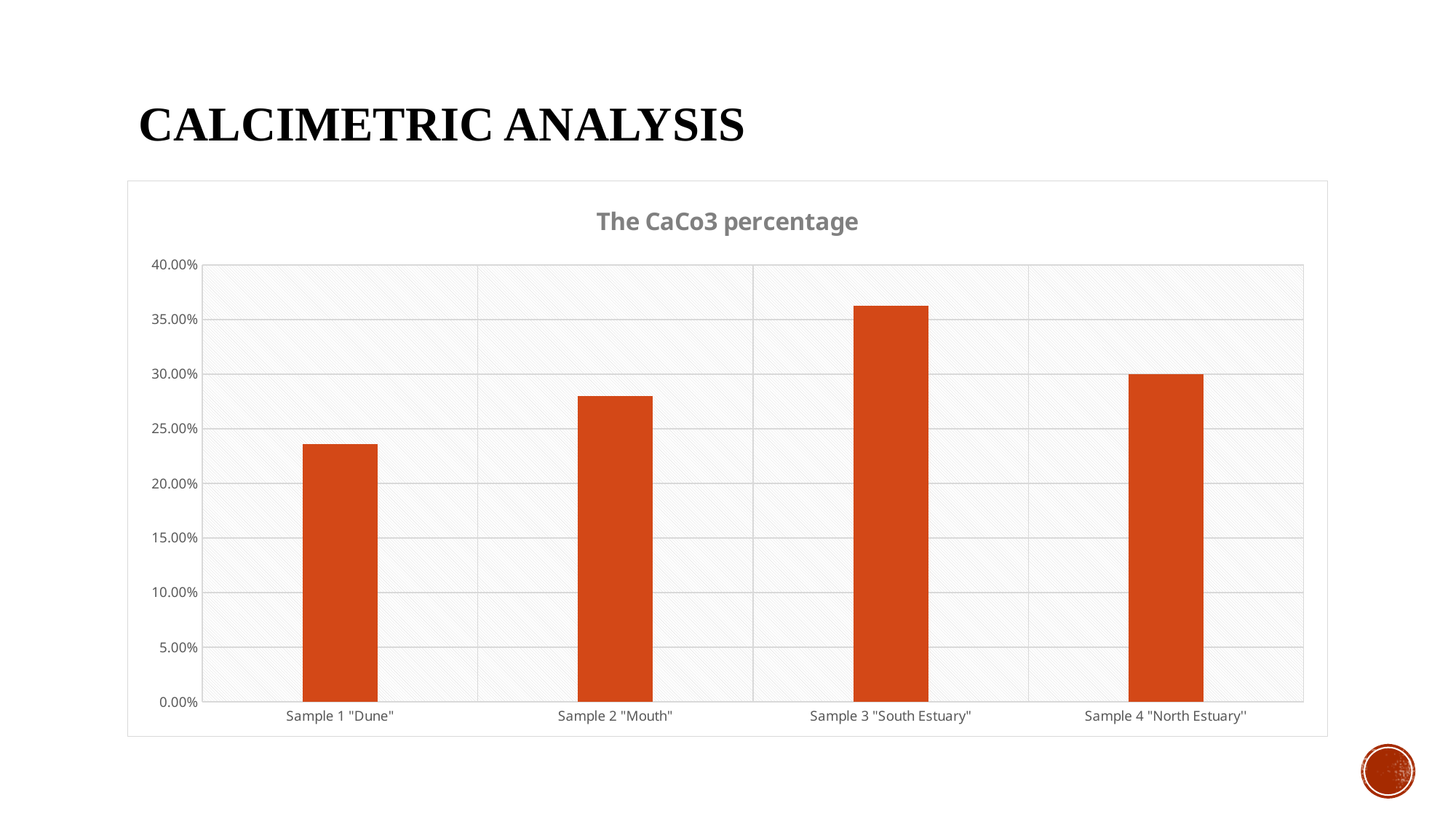
What is the highest value shown on the vertical axis of the chart? 40.00% Which has a higher CaCo3 percentage, Sample 1 "Dune" or Sample 2 "Mouth"? Sample 2 "Mouth" How many samples are plotted in the chart? 4 Which sample has the lowest CaCo3 percentage? Sample 1 "Dune" What kind of chart is shown on the slide? bar chart Is the value for Sample 2 "Mouth" greater or less than 25.00%? greater What is the title of the chart? The CaCo3 percentage Which has a higher CaCo3 percentage, Sample 2 "Mouth" or Sample 4 "North Estuary"? Sample 4 "North Estuary" Is the value for Sample 3 "South Estuary" greater or less than 35.00%? greater Is the value for Sample 1 "Dune" greater or less than 25.00%? less Which sample has the highest CaCo3 percentage? Sample 3 "South Estuary"